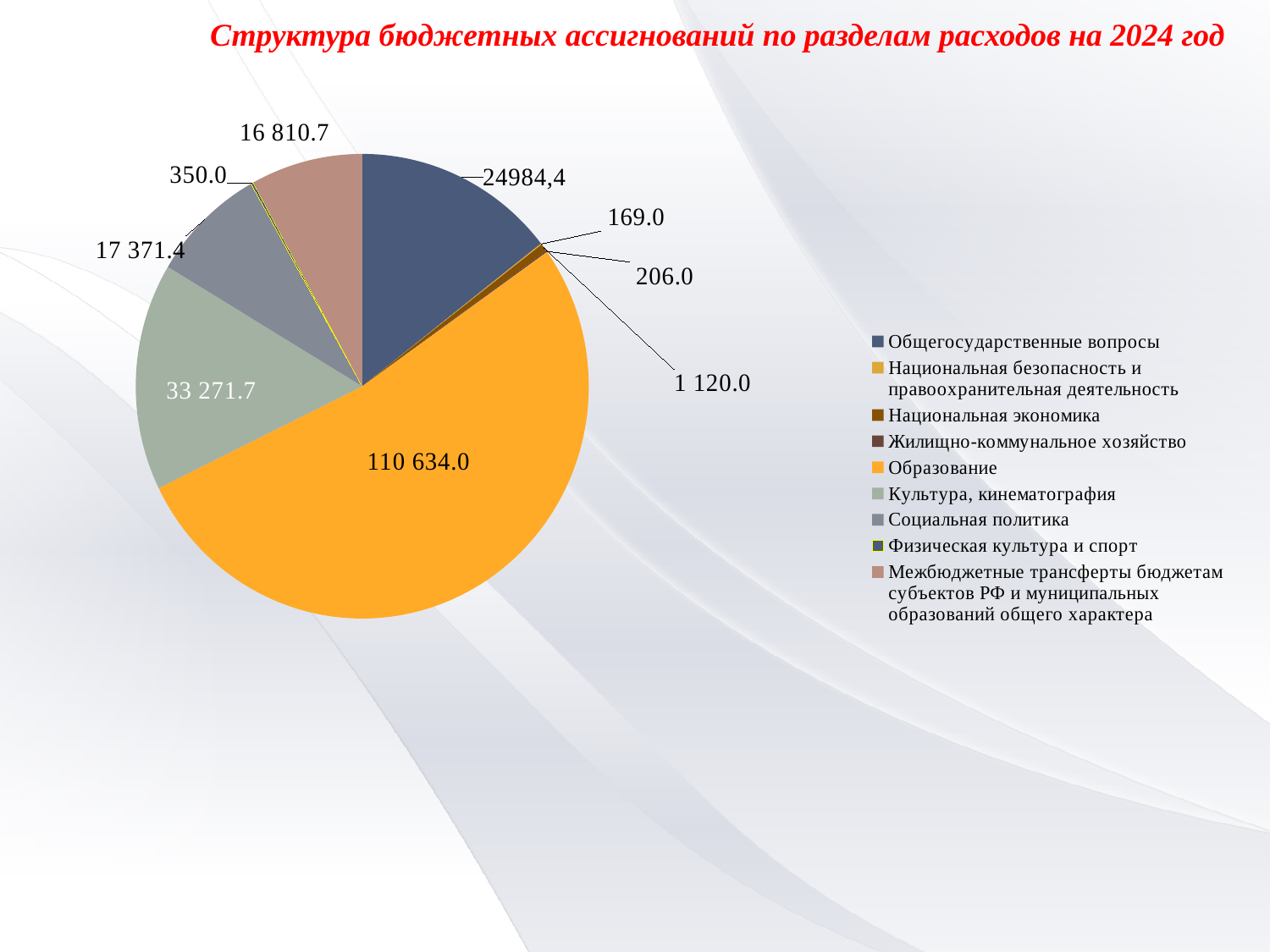
What is the difference between the values for Социальная политика and Межбюджетные трансферты бюджетам субъектов РФ и муниципальных образований общего характера? 560.7 Which category has the largest slice of the pie? Образование What is the value shown for Культура, кинематография? 33 271.7 What is the value shown for Социальная политика? 17 371.4 What kind of chart is shown on the slide? pie chart Which is larger: Культура, кинематография or Социальная политика? Культура, кинематография What is the value shown for Образование? 110 634.0 What is the title of the chart? Структура бюджетных ассигнований по разделам расходов на 2024 год What colour is the slice for Образование? orange What is the value shown for Общегосударственные вопросы? 24984,4 What is the value shown for Физическая культура и спорт? 350.0 How many categories does the legend list? 9